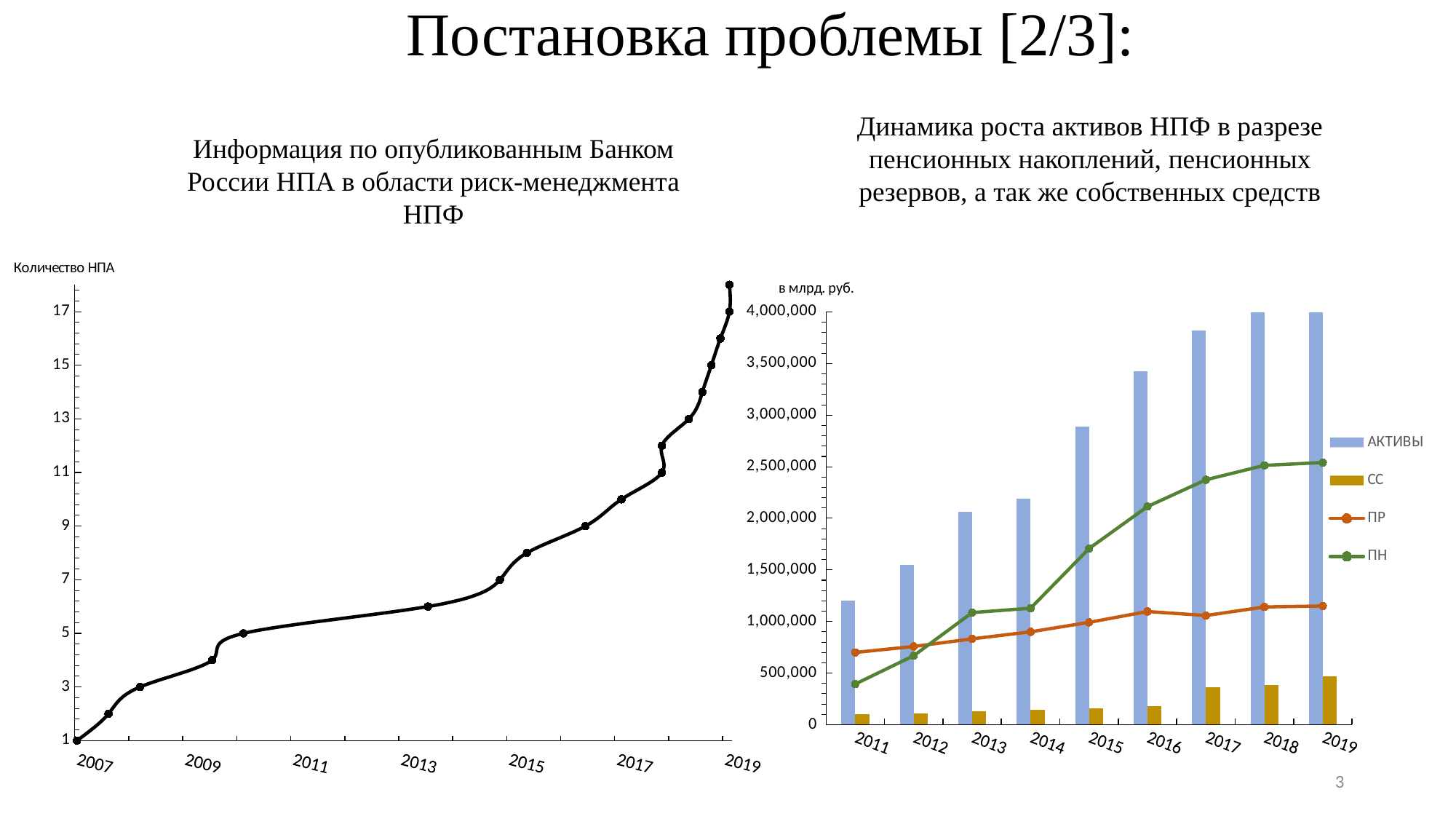
In the right chart (в млрд. руб.), which year has the highest ПН value? 2019 How many years are shown on the x axis of the right chart (в млрд. руб.)? 9 In the right chart (в млрд. руб.), which year has the lowest АКТИВЫ value? 2011 In the right chart (в млрд. руб.), is the ПН value for 2016 greater or less than 2,000,000? greater How many series does the legend of the right chart (в млрд. руб.) list? 4 In the right chart (в млрд. руб.), is the АКТИВЫ value for 2011 greater or less than 1,500,000? less In the left chart (Количество НПА), is the value at 2013 greater or less than 7? less In the right chart (в млрд. руб.), which is larger in 2011: ПР or ПН? ПР What are the legend entries of the right chart (в млрд. руб.)? АКТИВЫ, СС, ПР, ПН What kind of chart is the left chart (Количество НПА)? line chart In the left chart (Количество НПА), do the values rise or fall from 2007 to 2019? rise